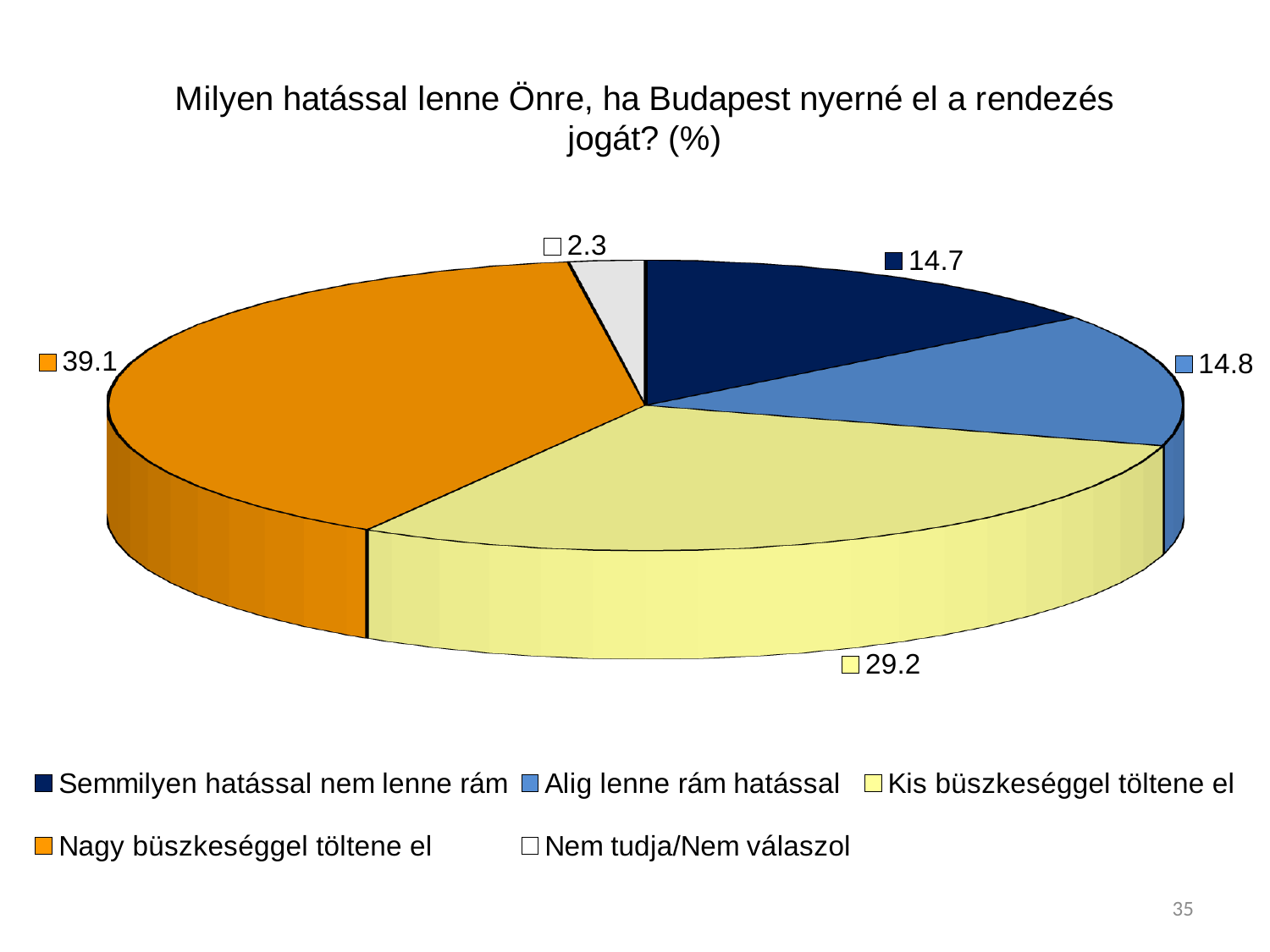
What value is shown for the slice "Kis büszkeséggel töltene el"? 29.2 What value is shown for the slice "Alig lenne rám hatással"? 14.8 Which category has the smallest slice of the pie? Nem tudja/Nem válaszol What kind of chart is shown on the slide? Pie chart What value is shown for the slice "Nem tudja/Nem válaszol"? 2.3 What value is shown for the slice "Semmilyen hatással nem lenne rám"? 14.7 What value is shown for the slice "Nagy büszkeséggel töltene el"? 39.1 What is the difference between the values for "Nagy büszkeséggel töltene el" and "Kis büszkeséggel töltene el"? 9.9 What colour is the slice for "Nagy büszkeséggel töltene el"? Orange Which is larger: the value for "Kis büszkeséggel töltene el" or the value for "Semmilyen hatással nem lenne rám"? Kis büszkeséggel töltene el How many slices does the pie chart have? 5 Which category has the largest slice of the pie? Nagy büszkeséggel töltene el